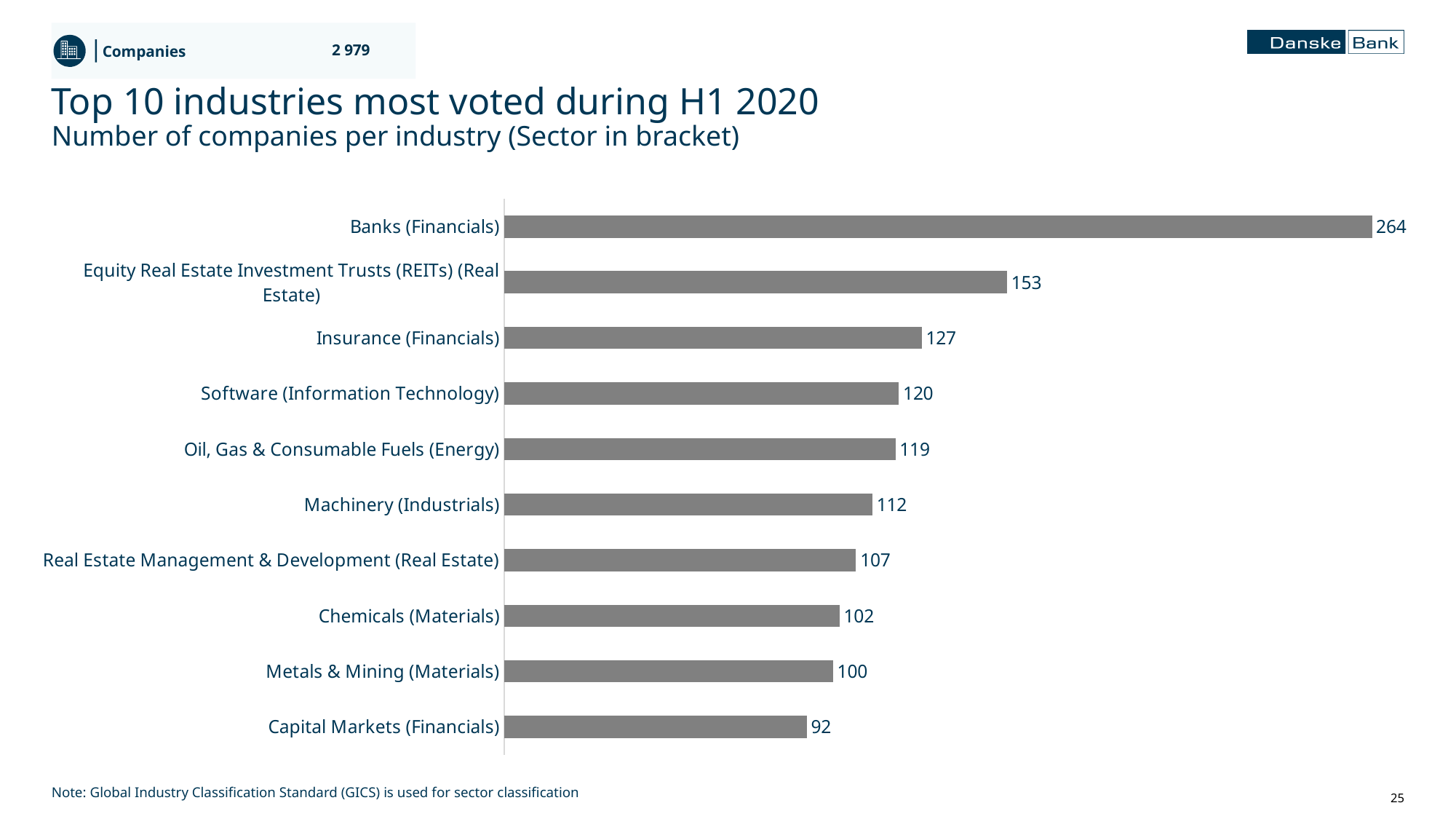
What is the number of companies for Metals & Mining (Materials)? 100 How many industries are shown in the chart? 10 What is the number of companies for Banks (Financials)? 264 What kind of chart is shown on the slide? Bar chart Which has more companies, Machinery (Industrials) or Real Estate Management & Development (Real Estate)? Machinery (Industrials) What is the difference between the number of companies for Insurance (Financials) and Chemicals (Materials)? 25 What is the title of the chart? Top 10 industries most voted during H1 2020 Which industry has the highest number of companies? Banks (Financials) What is the difference between the number of companies for Banks (Financials) and Equity Real Estate Investment Trusts (REITs) (Real Estate)? 111 Which industry has the lowest number of companies? Capital Markets (Financials) What is the number of companies for Oil, Gas & Consumable Fuels (Energy)? 119 What is the number of companies for Software (Information Technology)? 120